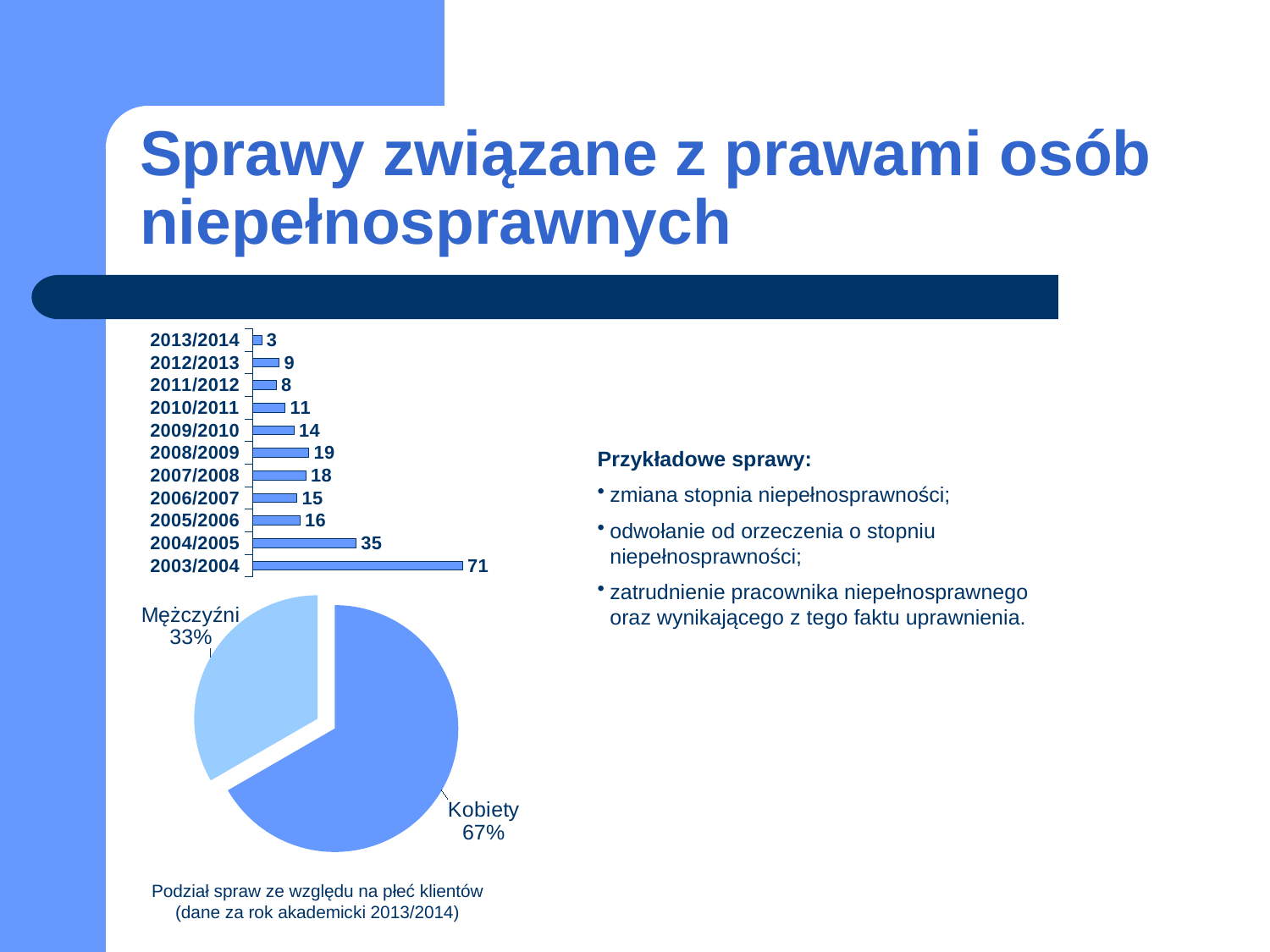
In the pie chart, what share is labelled Mężczyźni? 33% In the pie chart, what share is labelled Kobiety? 67% In the bar chart, what is the value for 2013/2014? 3 In the bar chart, which academic year has the highest value? 2003/2004 In the bar chart, what is the difference between the values for 2003/2004 and 2004/2005? 36 In the bar chart, what is the value for 2008/2009? 19 In the bar chart, what is the value for 2003/2004? 71 How many academic years are shown in the bar chart? 11 In the bar chart, which academic year has the lowest value? 2013/2014 What kind of chart is the upper chart on the slide? bar chart What kind of chart is the lower chart on the slide? pie chart In the bar chart, which is larger, the value for 2007/2008 or the value for 2010/2011? 2007/2008